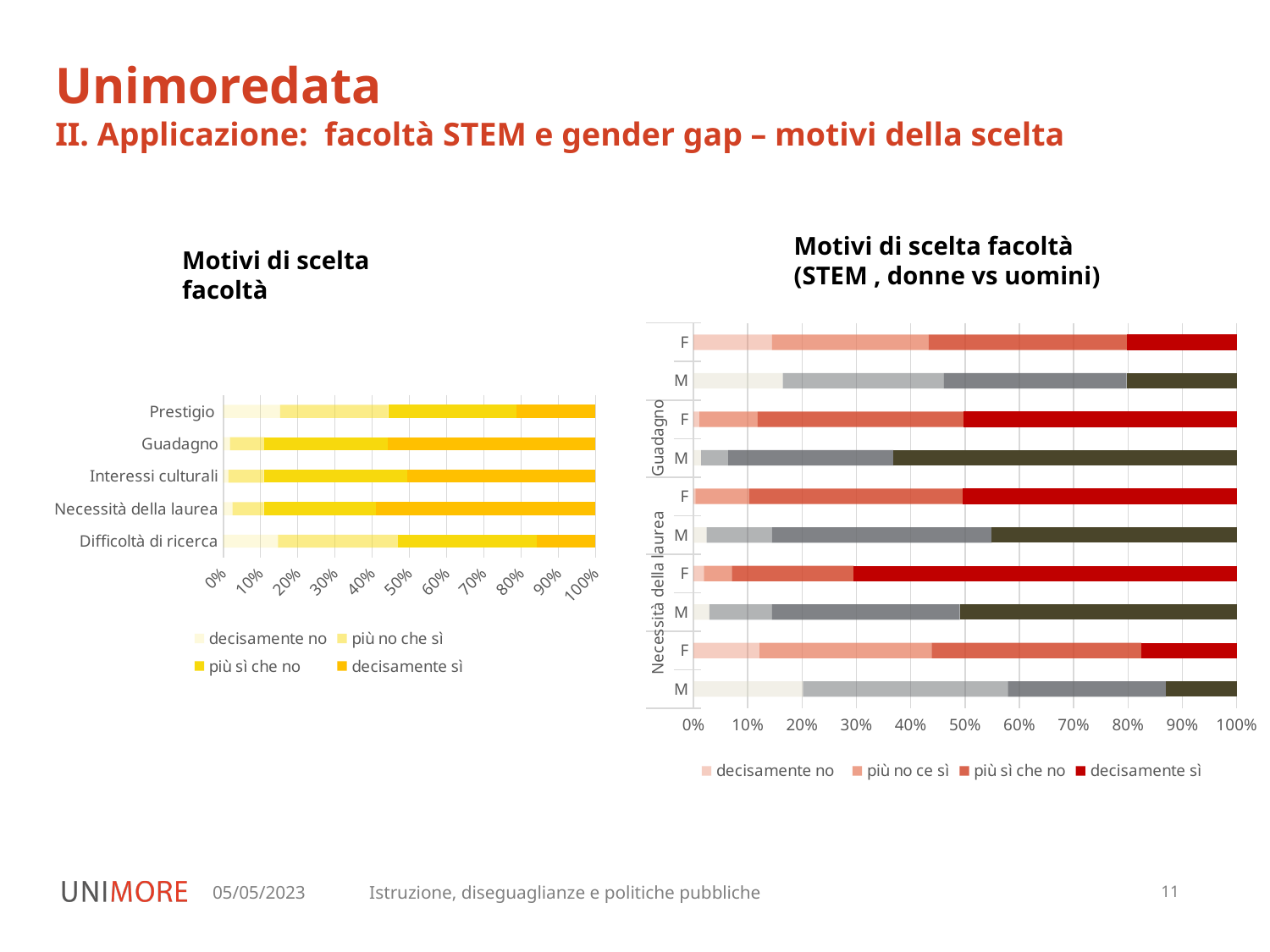
On the right chart "Motivi di scelta facoltà (STEM, donne vs uomini)", what is the last legend entry? decisamente sì How many series does the legend of the right chart "Motivi di scelta facoltà (STEM, donne vs uomini)" list? 4 On the left chart "Motivi di scelta facoltà", which has the larger "decisamente no" share: Prestigio or Necessità della laurea? Prestigio On the left chart "Motivi di scelta facoltà", is the "decisamente no" share for Necessità della laurea greater or less than 10%? less What kind of chart is the right chart "Motivi di scelta facoltà (STEM, donne vs uomini)"? Stacked bar chart How many series does the legend of the left chart "Motivi di scelta facoltà" list? 4 On the left chart "Motivi di scelta facoltà", is the "decisamente no" share for Prestigio greater or less than 10%? greater What kind of chart is the left chart titled "Motivi di scelta facoltà"? Stacked bar chart On the right chart "Motivi di scelta facoltà (STEM, donne vs uomini)", is the "decisamente no" share for the Guadagno F bar greater or less than 10%? less How many categories are shown on the left chart "Motivi di scelta facoltà"? 5 How many bars are plotted on the right chart "Motivi di scelta facoltà (STEM, donne vs uomini)"? 10 On the left chart "Motivi di scelta facoltà", which category is listed first at the top? Prestigio